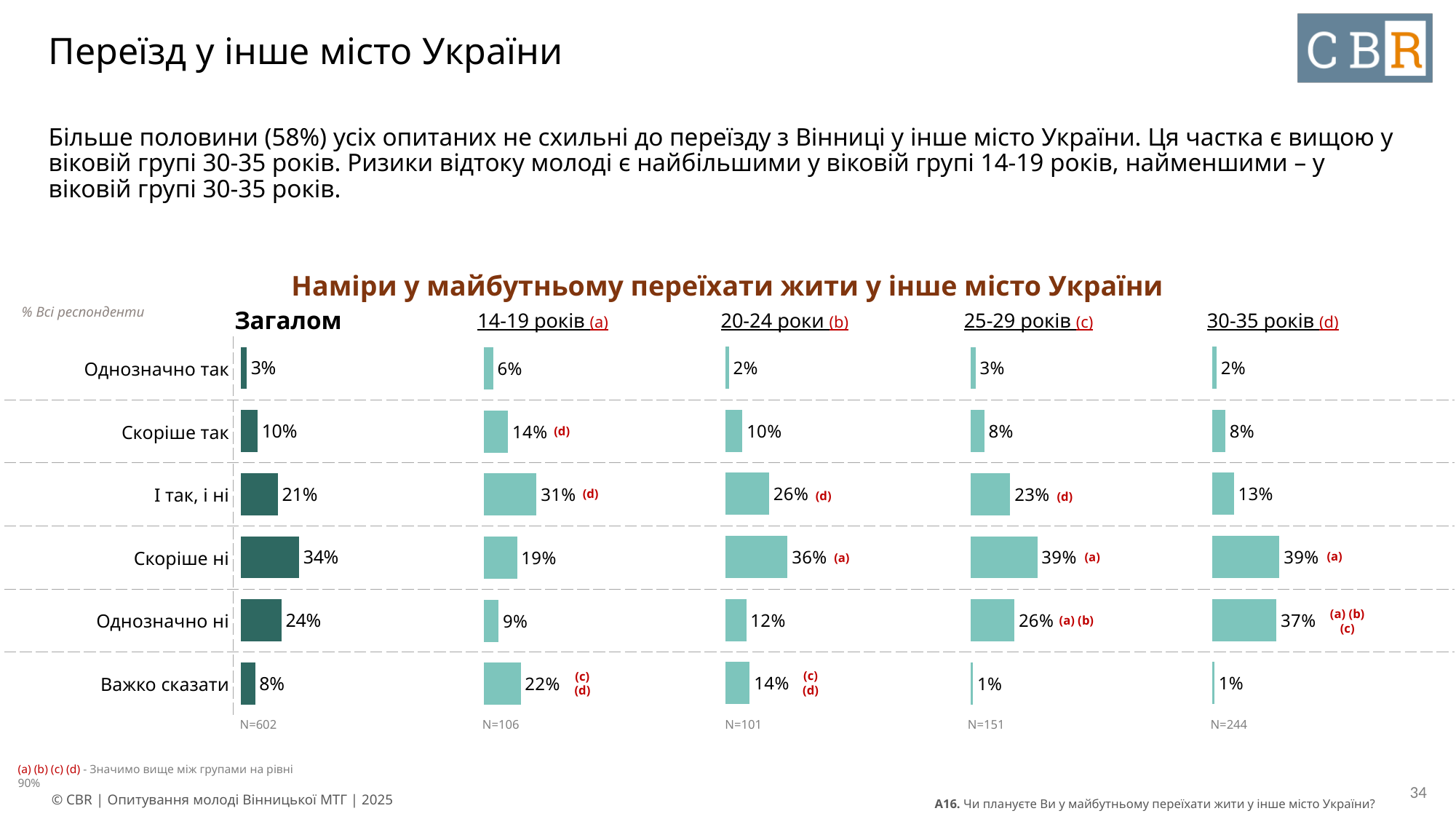
How many response categories are shown in the chart? 6 In the '14-19 років' panel, which category has the highest value? І так, і ні What is the title of the chart? Наміри у майбутньому переїхати жити у інше місто України In the 'Загалом' panel, what is the value for 'Скоріше ні'? 34% What is the sample size (N) shown for the '25-29 років' panel? N=151 In the '30-35 років' panel, which category has the lowest value? Важко сказати In the '30-35 років' panel, what is the value for 'Однозначно ні'? 37% What type of chart is shown on the slide? Bar chart In the '14-19 років' panel, what is the value for 'Важко сказати'? 22% In the '25-29 років' panel, what is the value for 'І так, і ні'? 23% Which is larger: 'Скоріше так' in the '14-19 років' panel or in the '20-24 роки' panel? 14-19 років What is the difference between 'Однозначно ні' in the '30-35 років' panel and in the '14-19 років' panel? 28%